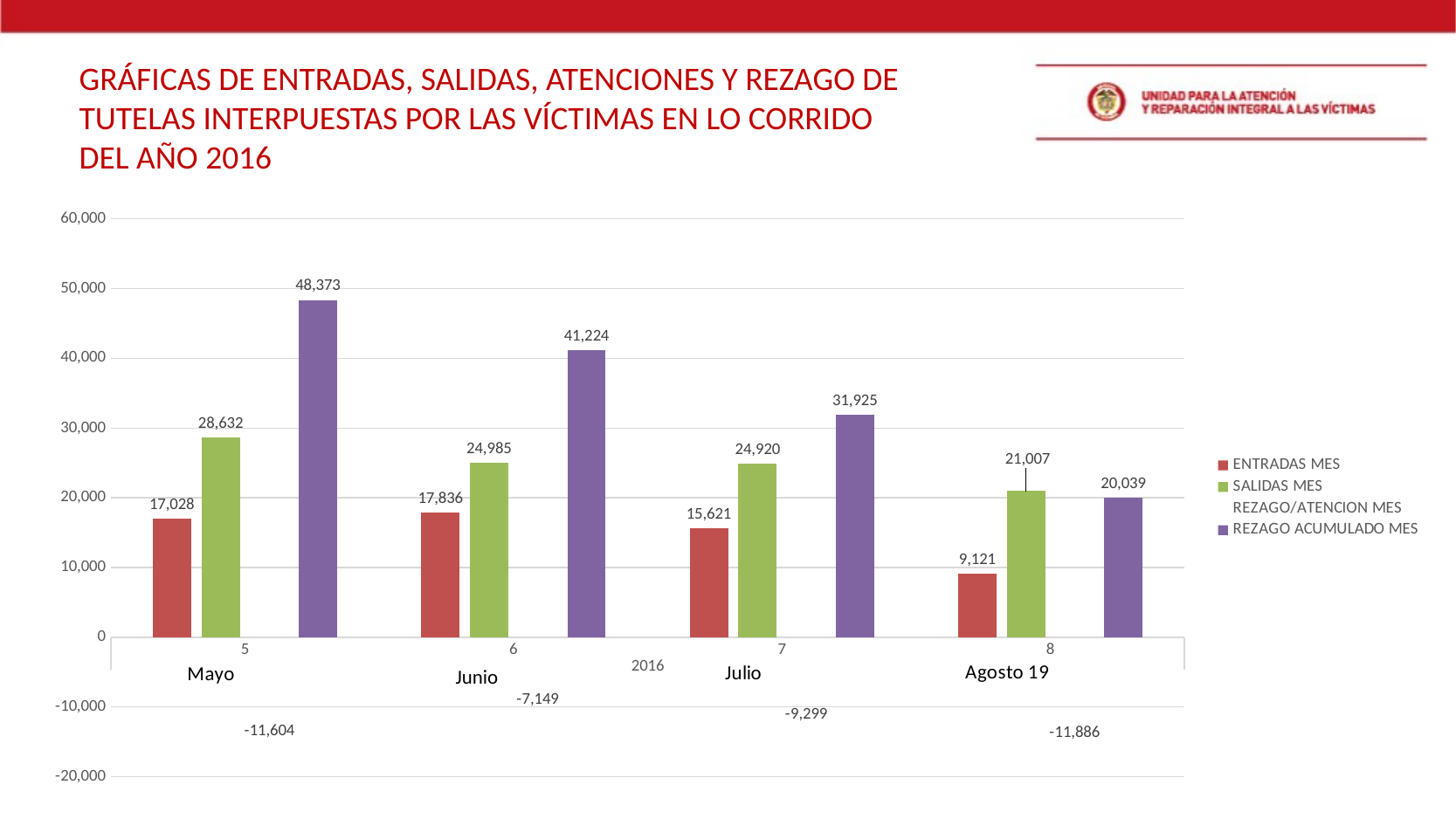
How many series does the legend list? 4 What kind of chart is shown on the slide? Bar chart Does the REZAGO ACUMULADO MES value rise or fall from Mayo to Agosto 19? Fall Which is larger for Junio: ENTRADAS MES or SALIDAS MES? SALIDAS MES What is the difference between SALIDAS MES and ENTRADAS MES for Julio? 9,299 Which month has the highest REZAGO ACUMULADO MES value? Mayo What is the value of SALIDAS MES for Junio? 24,985 What is the value of ENTRADAS MES for Mayo? 17,028 Which month has the lowest ENTRADAS MES value? Agosto 19 What is the value of ENTRADAS MES for Agosto 19? 9,121 What is the REZAGO/ATENCION MES value shown for Mayo? -11,604 What is the value of REZAGO ACUMULADO MES for Julio? 31,925